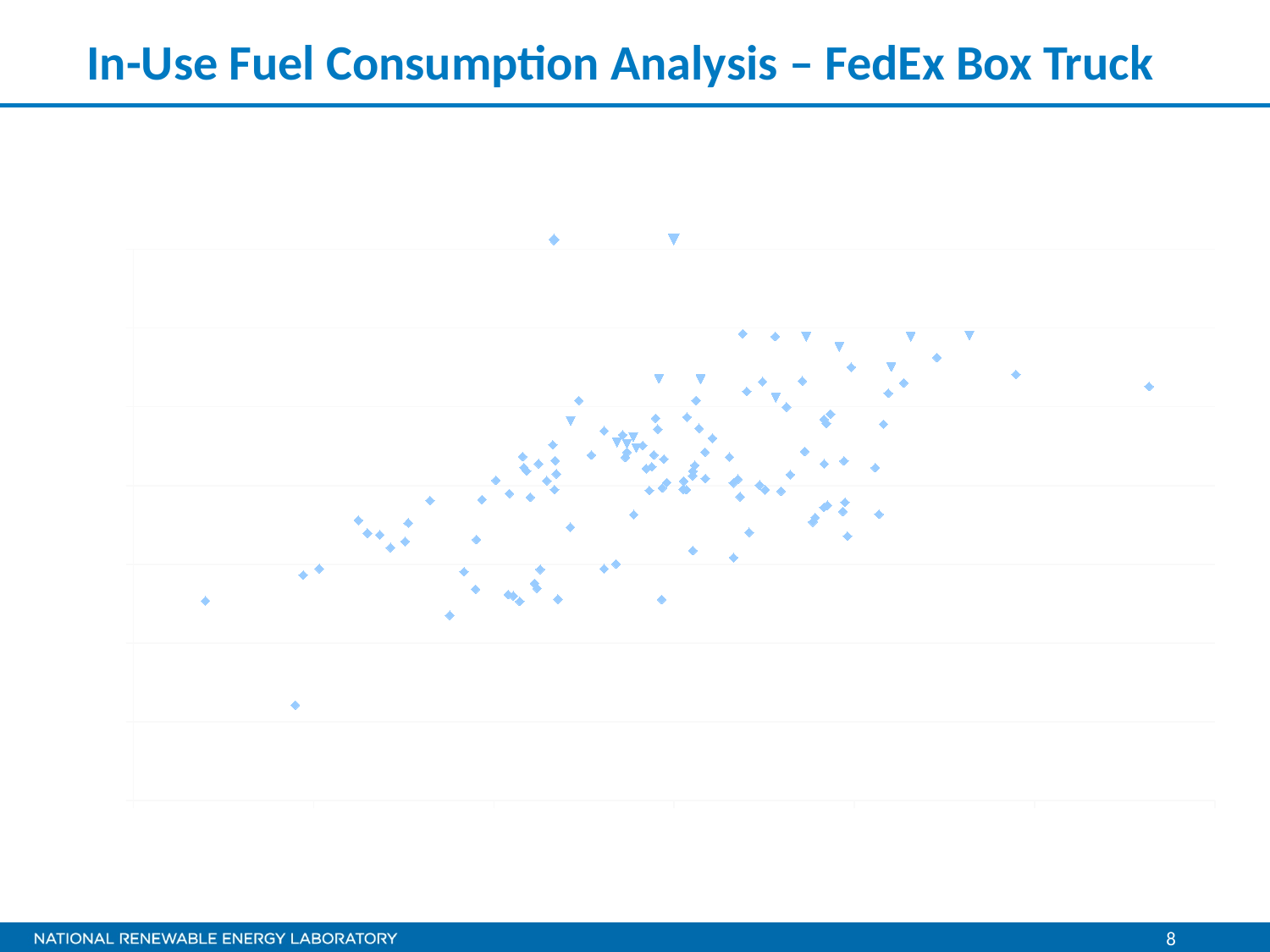
What is the title of the slide containing the chart? In-Use Fuel Consumption Analysis – FedEx Box Truck Do the plotted values generally rise or fall as you move from left to right along the x axis? rise What kind of chart is shown on the slide? scatter chart What two marker shapes are used for the points in the chart? diamonds and triangles